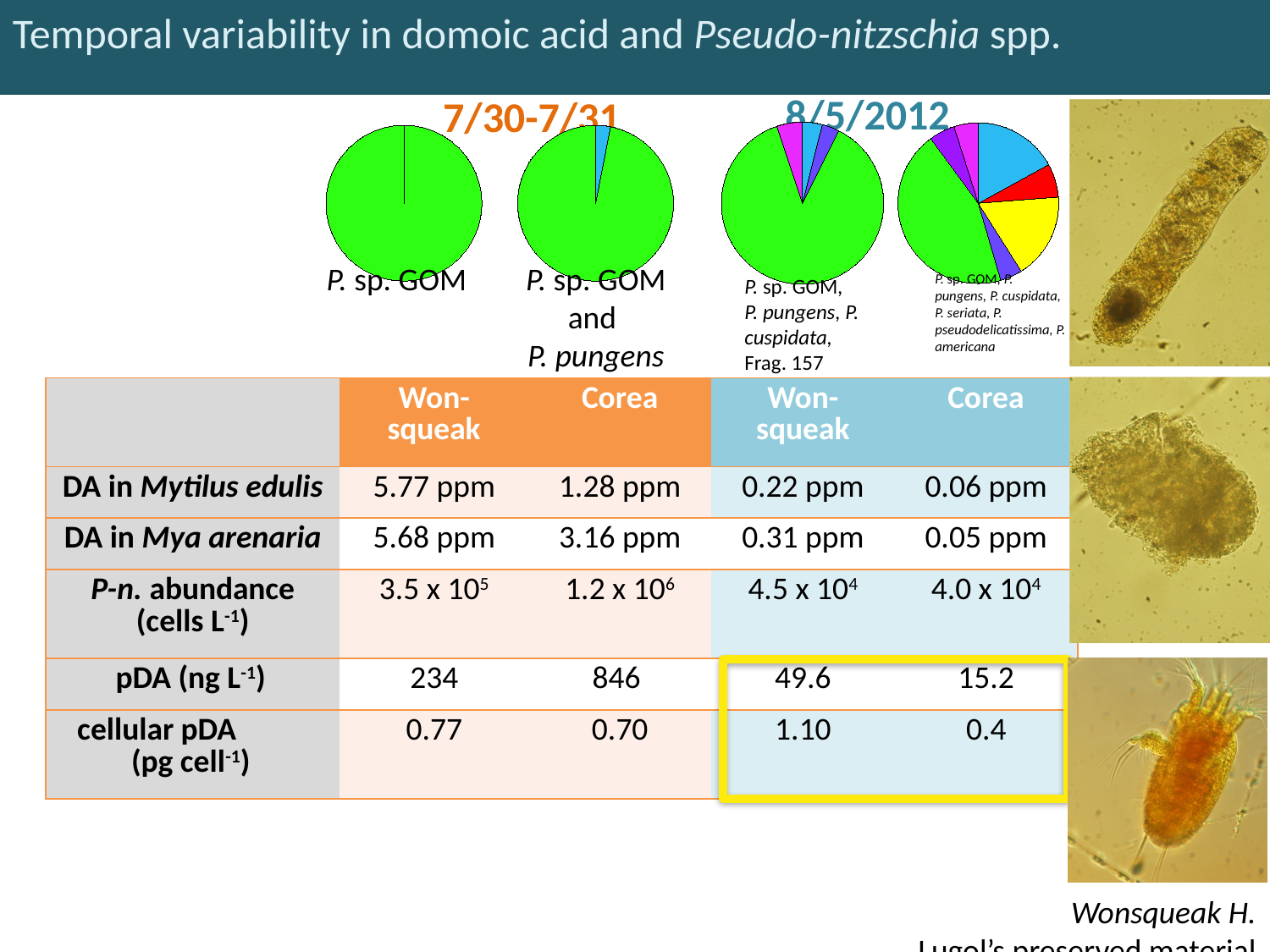
How many pie charts are shown on the slide? 4 Which date label is shown above the two left-hand pie charts? 7/30-7/31 Which of the four pie charts has the largest green slice? The leftmost pie chart (P. sp. GOM, 7/30-7/31) What kind of charts are shown at the top of the slide? Pie charts In the rightmost pie chart, is the green slice larger or smaller than the red slice? larger In the second pie chart from the left, is the green slice more or less than half of the pie? more Which of the four pie charts is divided into the most slices? The rightmost pie chart (8/5/2012) Which date label is shown above the two right-hand pie charts? 8/5/2012